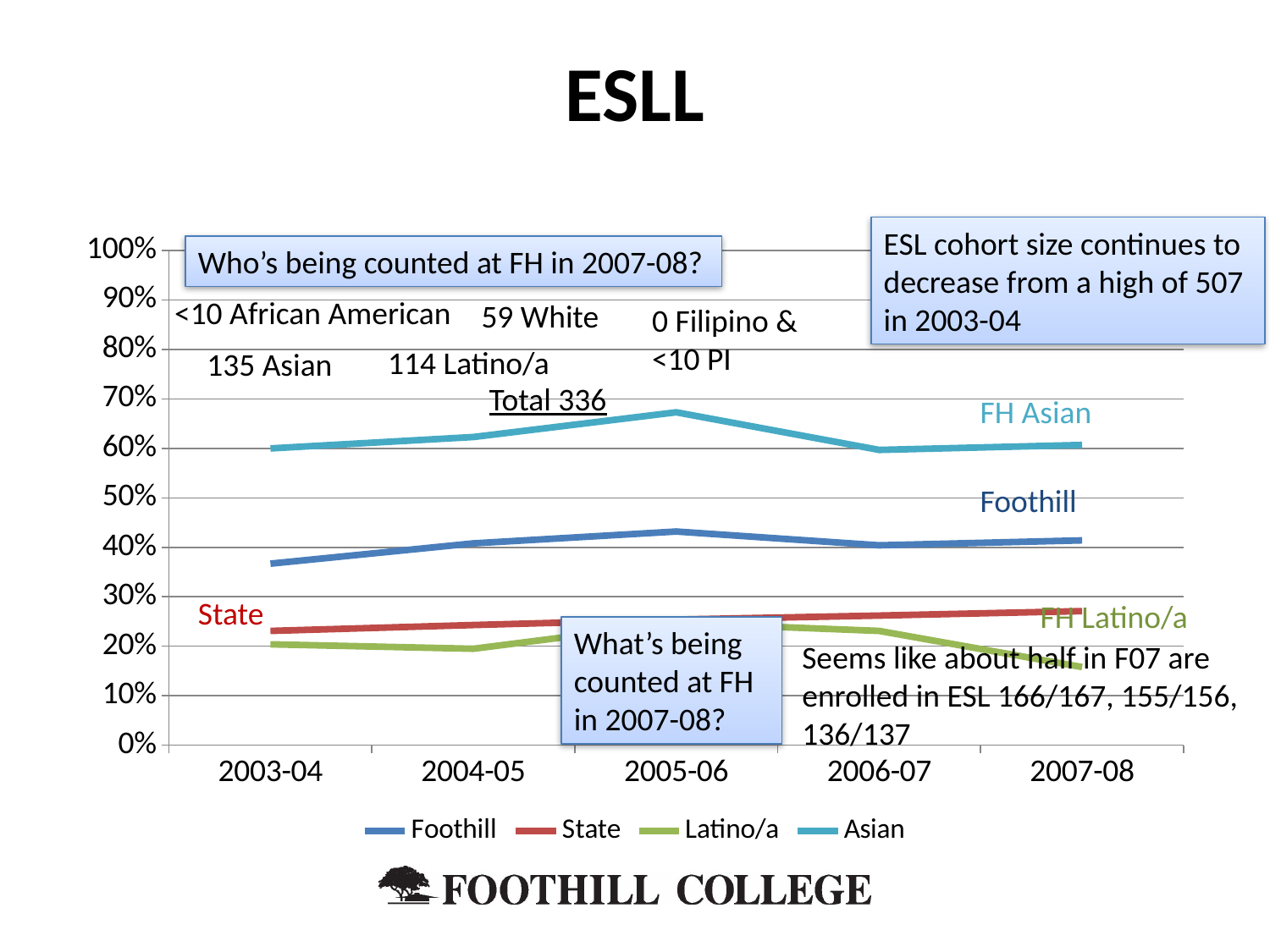
In 2003-04, which is higher: the Asian series or the Foothill series? Asian Is the value for the Foothill series in 2003-04 greater or less than 40%? less How many academic years are plotted along the x axis? 5 Is the value for the Latino/a series in 2007-08 greater or less than 20%? less Does the State series rise or fall from 2003-04 to 2007-08? rise In which year does the Latino/a series reach its lowest value? 2007-08 In 2007-08, which is higher: the State series or the Latino/a series? State Is the value for the State series in 2003-04 greater or less than 20%? greater In which year does the Asian series reach its highest value? 2005-06 How many series does the legend list? 4 What kind of chart is shown on the slide? line chart